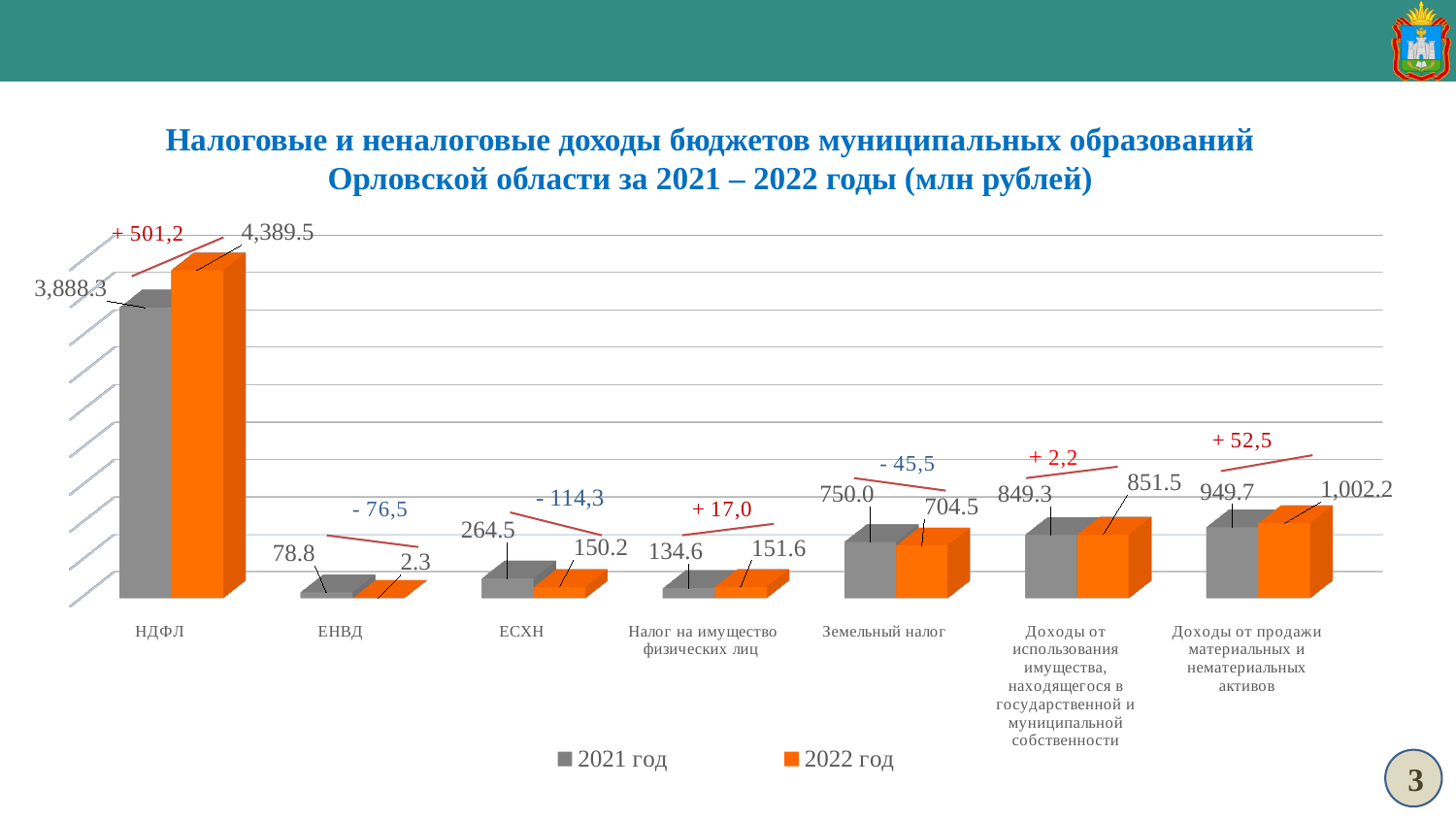
What is the value for ЕСХН in the 2021 год series? 264.5 What kind of chart is shown on the slide? Bar chart Which category has the lowest value in the 2022 год series? ЕНВД What colour represents the 2022 год series? Orange Which category has the highest value in the 2021 год series? НДФЛ Which is larger for ЕСХН: the 2021 год value or the 2022 год value? 2021 год What is the value for НДФЛ in the 2022 год series? 4,389.5 How many series does the legend list? 2 What is the value for ЕНВД in the 2021 год series? 78.8 What is the difference between the 2022 год and 2021 год values for Налог на имущество физических лиц? 17.0 What is the value for Земельный налог in the 2022 год series? 704.5 How many categories are shown on the x axis? 7